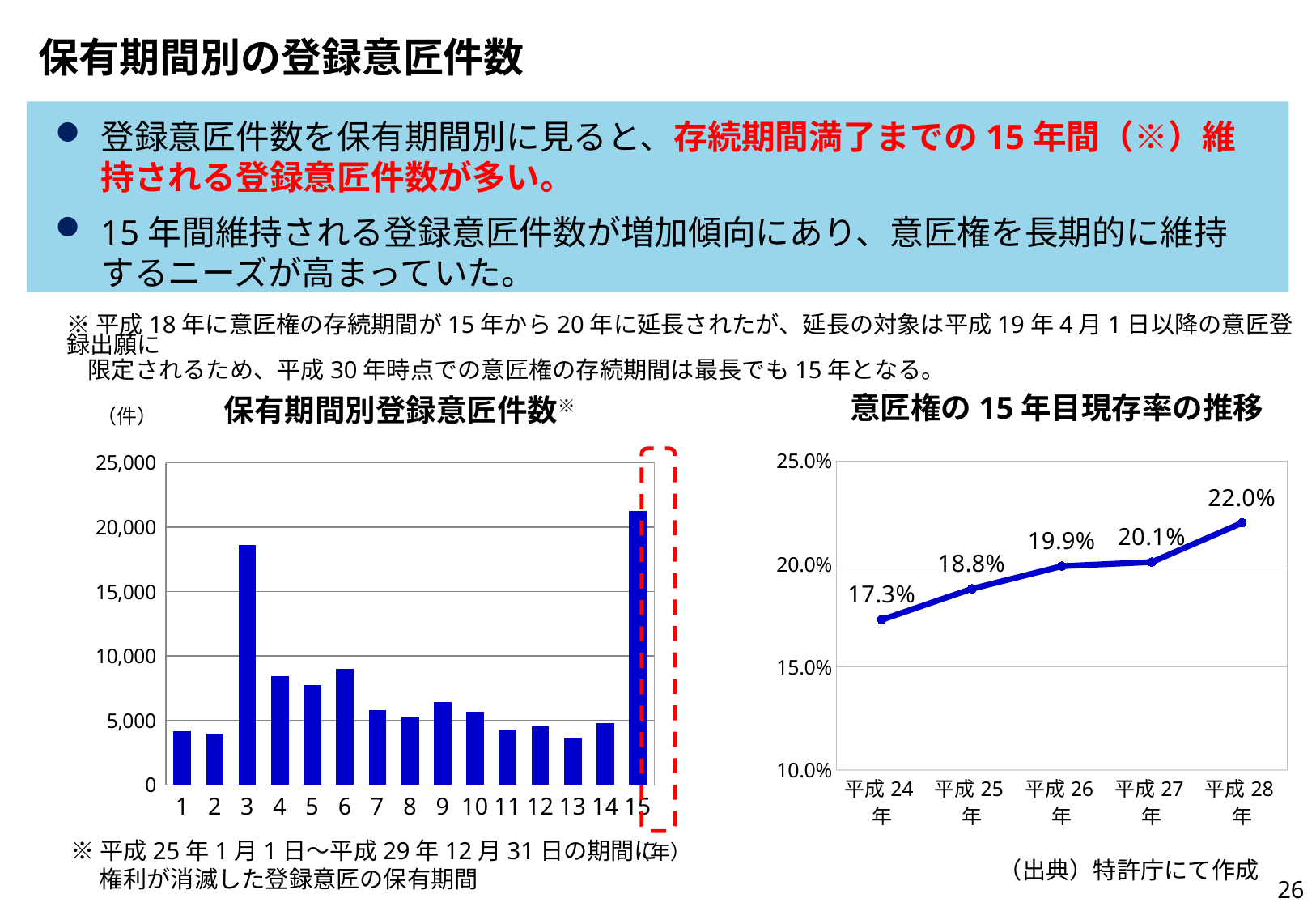
In the chart titled 意匠権の15年目現存率の推移, how many data points are plotted? 5 In the chart titled 意匠権の15年目現存率の推移, which year has the lowest value? 平成24年 What kind of chart is the chart titled 保有期間別登録意匠件数? bar chart In the chart titled 保有期間別登録意匠件数, which holding period has the highest number of registrations? 15 In the chart titled 意匠権の15年目現存率の推移, what is the value for 平成24年? 17.3% In the chart titled 保有期間別登録意匠件数, is the value for holding period 3 greater or less than 15,000? greater In the chart titled 意匠権の15年目現存率の推移, do the values rise or fall from 平成24年 to 平成28年? rise In the chart titled 意匠権の15年目現存率の推移, what is the difference between the values for 平成28年 and 平成24年? 4.7% In the chart titled 保有期間別登録意匠件数, which is larger, the value for holding period 4 or holding period 13? 4 In the chart titled 意匠権の15年目現存率の推移, what is the value for 平成28年? 22.0% In the chart titled 意匠権の15年目現存率の推移, what is the value for 平成26年? 19.9% In the chart titled 意匠権の15年目現存率の推移, which year has the highest value? 平成28年